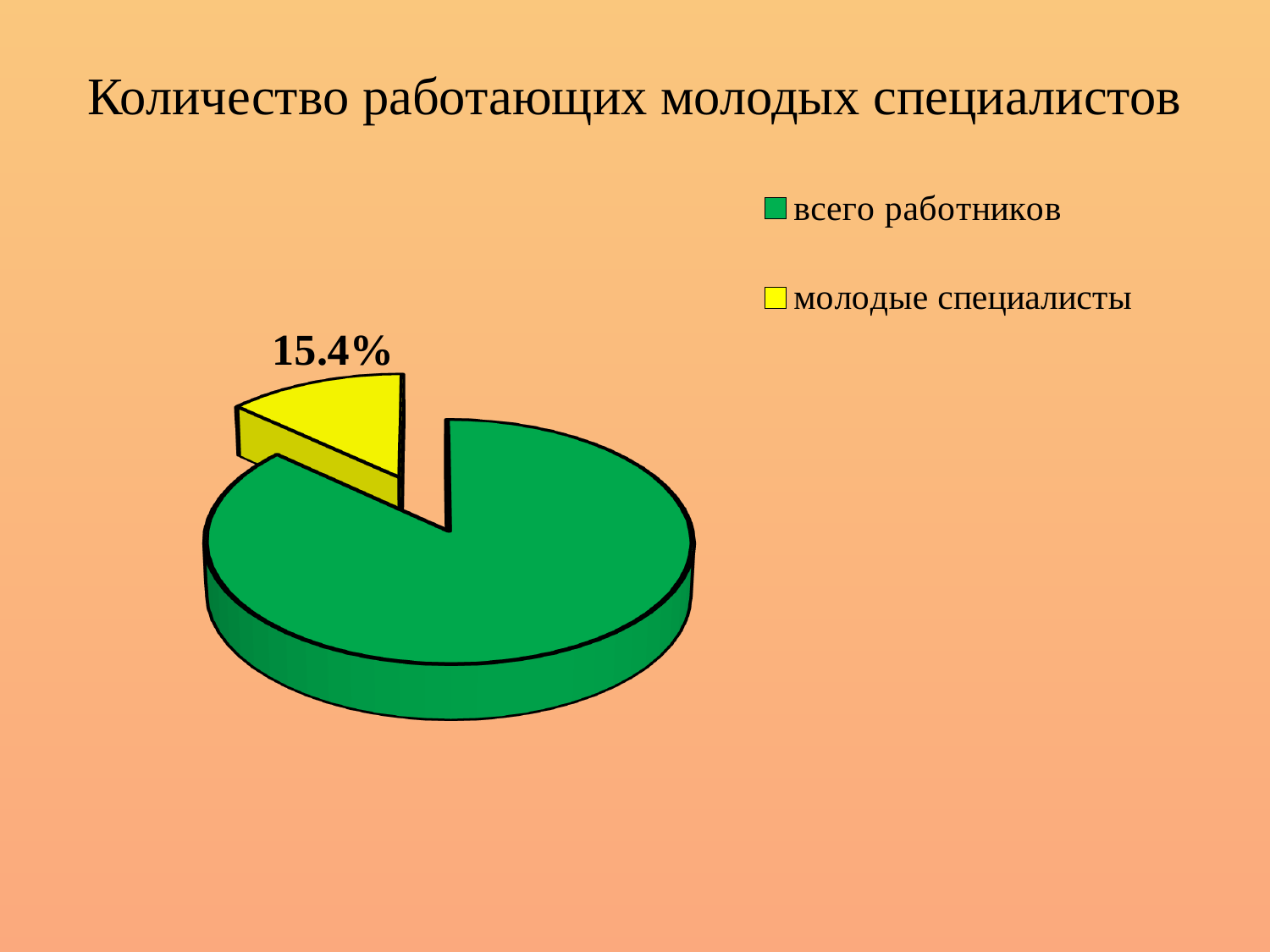
How many entries does the legend list? 2 Which is larger: the slice for всего работников or the slice for молодые специалисты? всего работников Is the share for молодые специалисты greater or less than 50%? less How many slices does the pie chart have? 2 What share of the pie is labelled for молодые специалисты? 15.4% What colour is the slice for молодые специалисты? yellow Which slice is the largest in the pie chart? всего работников What kind of chart is shown on the slide? pie chart Which slice is the smallest in the pie chart? молодые специалисты What is the title of the chart? Количество работающих молодых специалистов